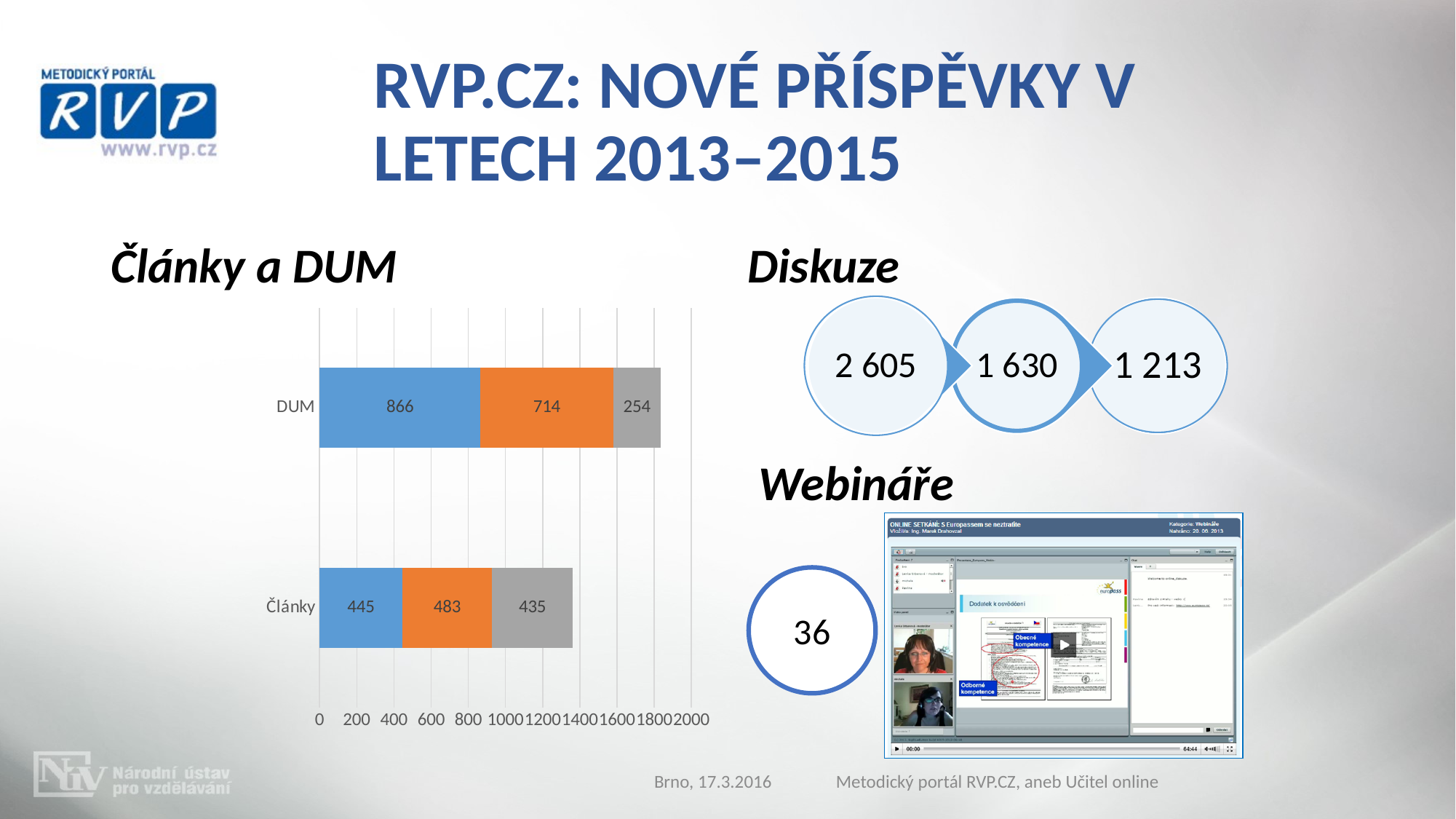
In the "Články a DUM" chart, which category has the longer stacked bar overall, DUM or Články? DUM In the "Články a DUM" chart, what is the total of the Články stacked bar? 1363 What is the highest value shown on the x axis of the "Články a DUM" chart? 2000 In the "Články a DUM" chart, what is the value of the blue segment of the DUM bar? 866 In the "Články a DUM" chart, what is the value of the grey segment of the DUM bar? 254 What kind of chart is the "Články a DUM" chart? bar chart How many categories does the "Články a DUM" bar chart show? 2 In the "Články a DUM" chart, which segment of the DUM bar is the smallest? grey (254) In the "Články a DUM" chart, what is the difference between the blue segment of DUM and the blue segment of Články? 421 In the "Články a DUM" chart, what is the difference between the grey segment of Články and the grey segment of DUM? 181 In the "Články a DUM" chart, what is the total of the DUM stacked bar? 1834 In the "Články a DUM" chart, what is the value of the orange segment of the Články bar? 483